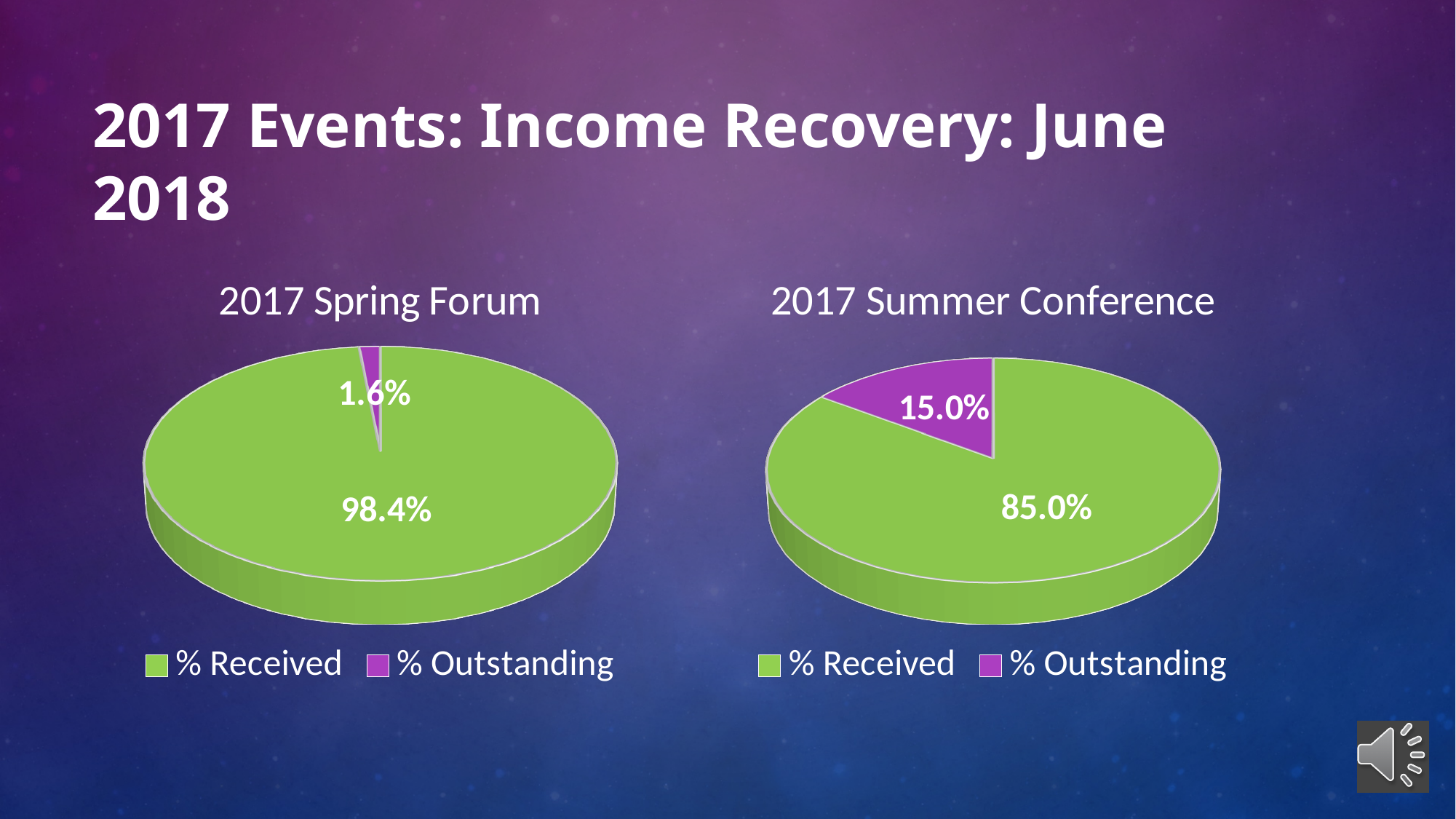
In the 2017 Summer Conference chart, which slice is the smallest? % Outstanding In the 2017 Summer Conference chart, what percentage is shown for % Received? 85.0% In the 2017 Summer Conference chart, what percentage is shown for % Outstanding? 15.0% In the 2017 Spring Forum chart, what percentage is shown for % Outstanding? 1.6% What is the difference between the % Received values in the 2017 Spring Forum chart and the 2017 Summer Conference chart? 13.4% How many slices does the 2017 Spring Forum pie chart have? 2 How many entries does the legend of the 2017 Summer Conference chart list? 2 In the 2017 Spring Forum chart, what percentage is shown for % Received? 98.4% Which chart shows a larger % Outstanding share, 2017 Spring Forum or 2017 Summer Conference? 2017 Summer Conference In the 2017 Summer Conference chart, what colour is the % Outstanding slice? Purple In the 2017 Spring Forum chart, which slice is the largest? % Received What type of chart is the 2017 Summer Conference chart? Pie chart